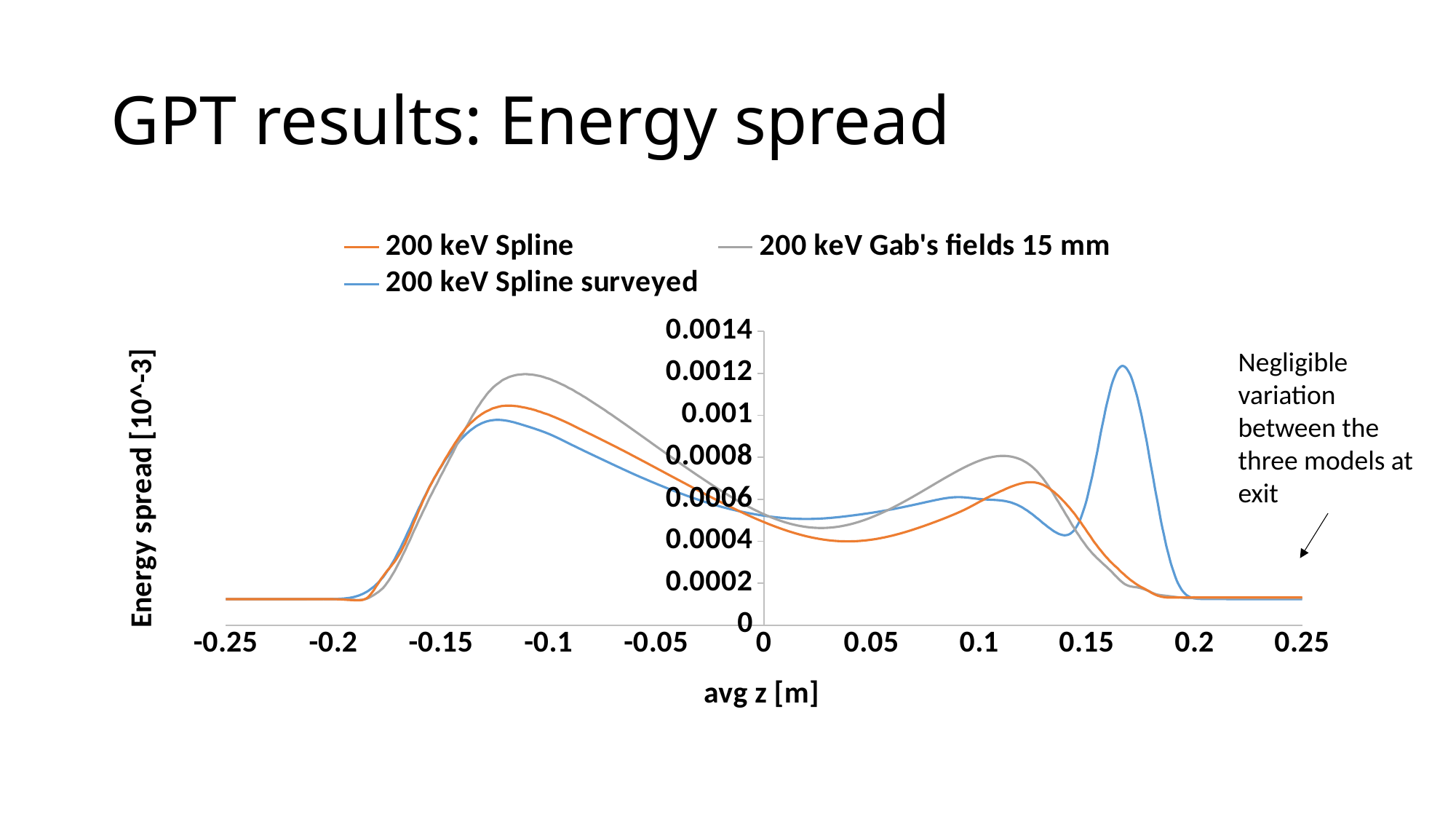
Is the value of the 200 keV Spline series at avg z = 0.05 greater or less than 0.0006? less How many series does the legend list? 3 Which series has the highest peak in the region where avg z is greater than 0.15? 200 keV Spline surveyed At avg z = -0.1, which series is higher: 200 keV Gab's fields 15 mm or 200 keV Spline surveyed? 200 keV Gab's fields 15 mm What does the annotation to the right of the chart say? Negligible variation between the three models at exit At avg z = 0.1, which series is higher: 200 keV Gab's fields 15 mm or 200 keV Spline? 200 keV Gab's fields 15 mm Is the peak value of the 200 keV Gab's fields 15 mm series near avg z = -0.11 greater or less than 0.001? greater What kind of chart is shown on the slide? line chart Is the value of the 200 keV Spline surveyed series at avg z = 0.25 greater or less than 0.0002? less What are the three series named in the legend? 200 keV Spline, 200 keV Gab's fields 15 mm, 200 keV Spline surveyed